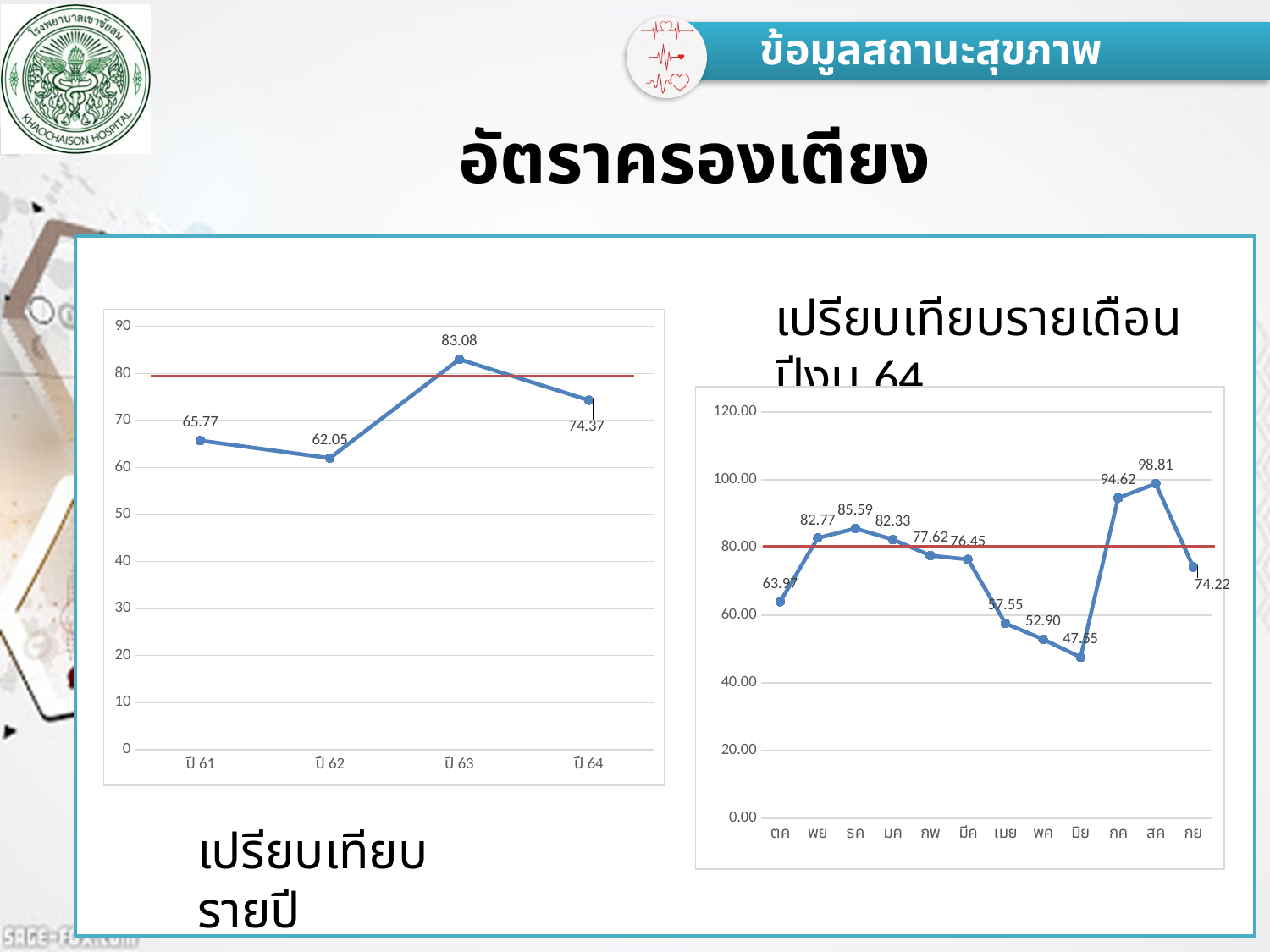
In the right chart (monthly comparison FY 64), which is larger, the value for ตค or the value for กย? กย In the left chart (yearly comparison), what is the difference between the values for ปี 63 and ปี 64? 8.71 In the right chart (monthly comparison FY 64), how many months are plotted? 12 In the right chart (monthly comparison FY 64), do the values rise or fall from ธค to มิย? Fall In the left chart (yearly comparison), what is the value for ปี 63? 83.08 In the left chart (yearly comparison), what kind of chart is shown? Line chart In the left chart (yearly comparison), how many years are plotted? 4 In the left chart (yearly comparison), which year has the lowest value? ปี 62 In the right chart (monthly comparison FY 64), what is the value for สค? 98.81 In the right chart (monthly comparison FY 64), which month has the highest value? สค In the right chart (monthly comparison FY 64), which month has the lowest value? มิย In the right chart (monthly comparison FY 64), what is the difference between the values for กค and มิย? 47.07